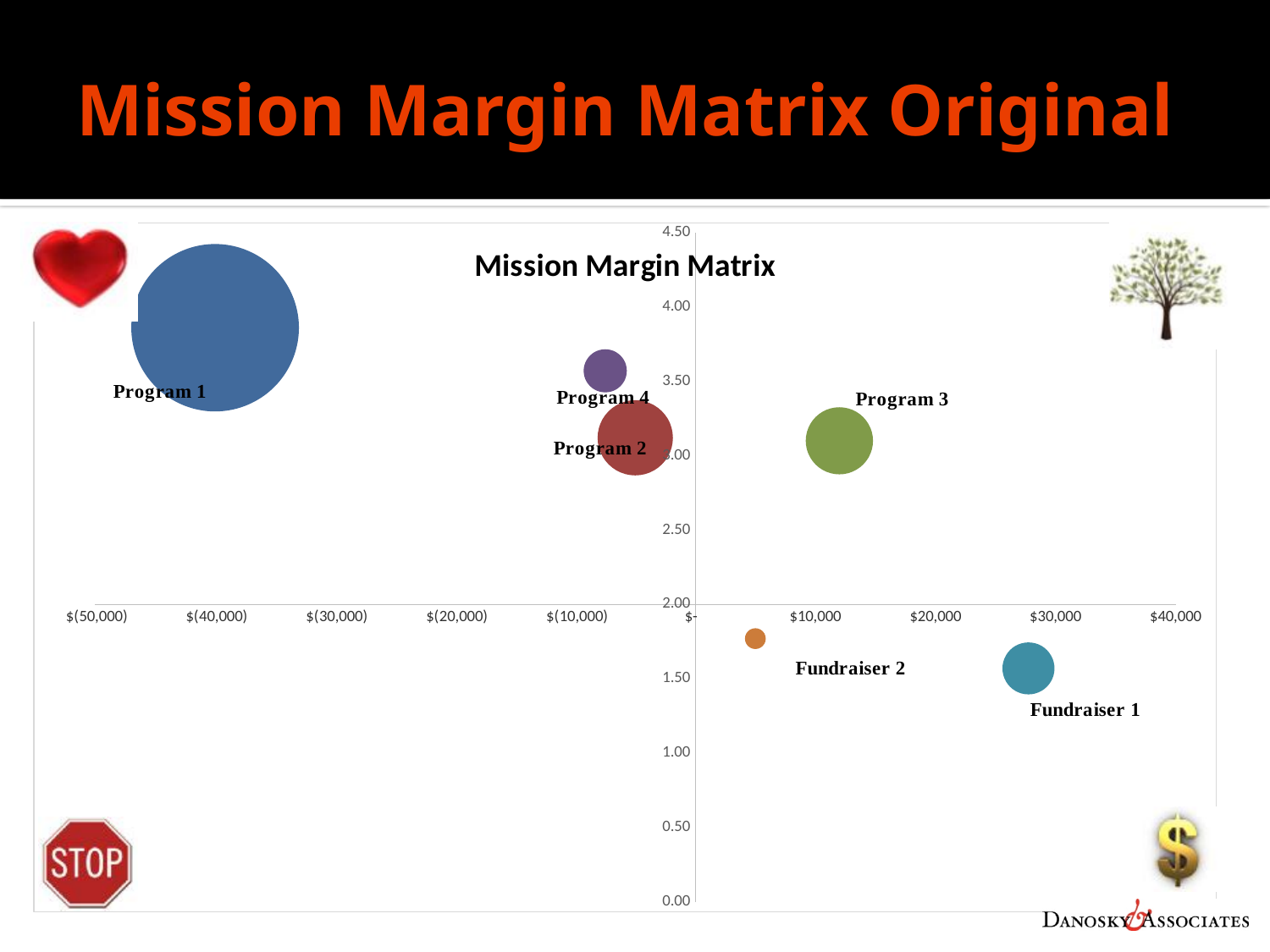
Is the vertical-axis value for Program 3 greater or less than 2.50? greater Which bubble is the largest on the chart? Program 1 How many labelled bubbles are plotted on the chart? 6 Which bubble is positioned lowest on the vertical axis? Fundraiser 1 What type of chart is shown on the slide? Bubble chart Is the vertical-axis value for Fundraiser 2 greater or less than 2.00? less Is the horizontal-axis value for Fundraiser 1 greater or less than $20,000? greater Which is positioned higher on the vertical axis, Program 1 or Fundraiser 1? Program 1 What is the title of the chart? Mission Margin Matrix Which bubble is the smallest on the chart? Fundraiser 2 Which bubble is positioned furthest to the right on the horizontal axis? Fundraiser 1